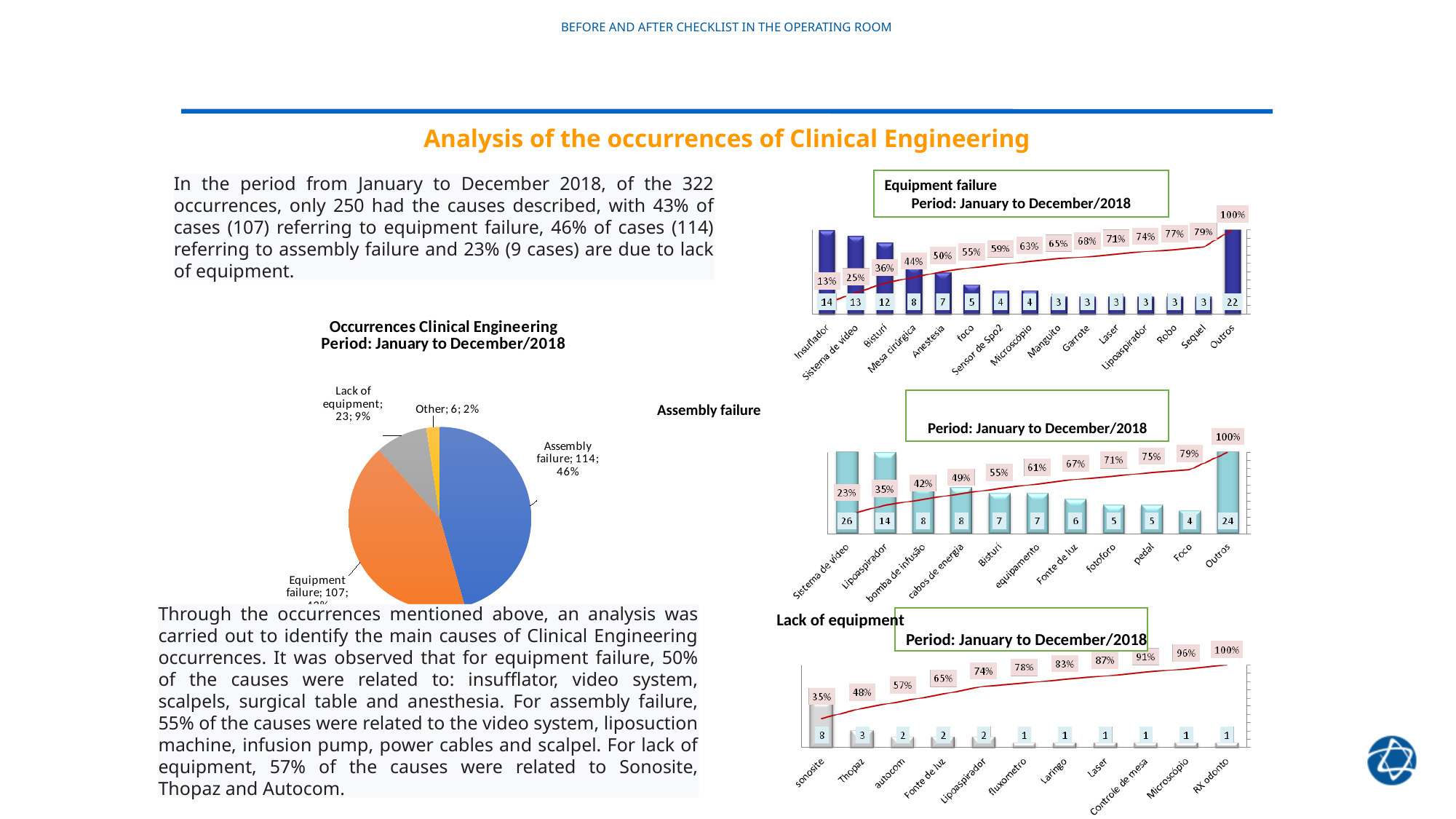
In the 'Equipment failure' chart, what is the difference between the values for Insuflador and Bisturi? 2 In the 'Lack of equipment' chart, how many categories are shown on the x axis? 11 In the 'Assembly failure' chart, what is the value for Lipoaspirador? 14 In the pie chart 'Occurrences Clinical Engineering', what percentage share does Assembly failure have? 46% In the pie chart 'Occurrences Clinical Engineering', how many categories are shown? 4 In the 'Equipment failure' chart, what is the value for Insuflador? 14 In the 'Lack of equipment' chart, what is the value for sonosite? 8 In the 'Assembly failure' chart, which is larger, the value for Fonte de luz or the value for Foco? Fonte de luz In the 'Assembly failure' chart, which category has the highest value? Sistema de vídeo In the 'Equipment failure' chart, what cumulative percentage is shown above Anestesia? 50% In the pie chart 'Occurrences Clinical Engineering', how many occurrences are labelled for Lack of equipment? 23 In the pie chart 'Occurrences Clinical Engineering', which category has the smallest slice? Other